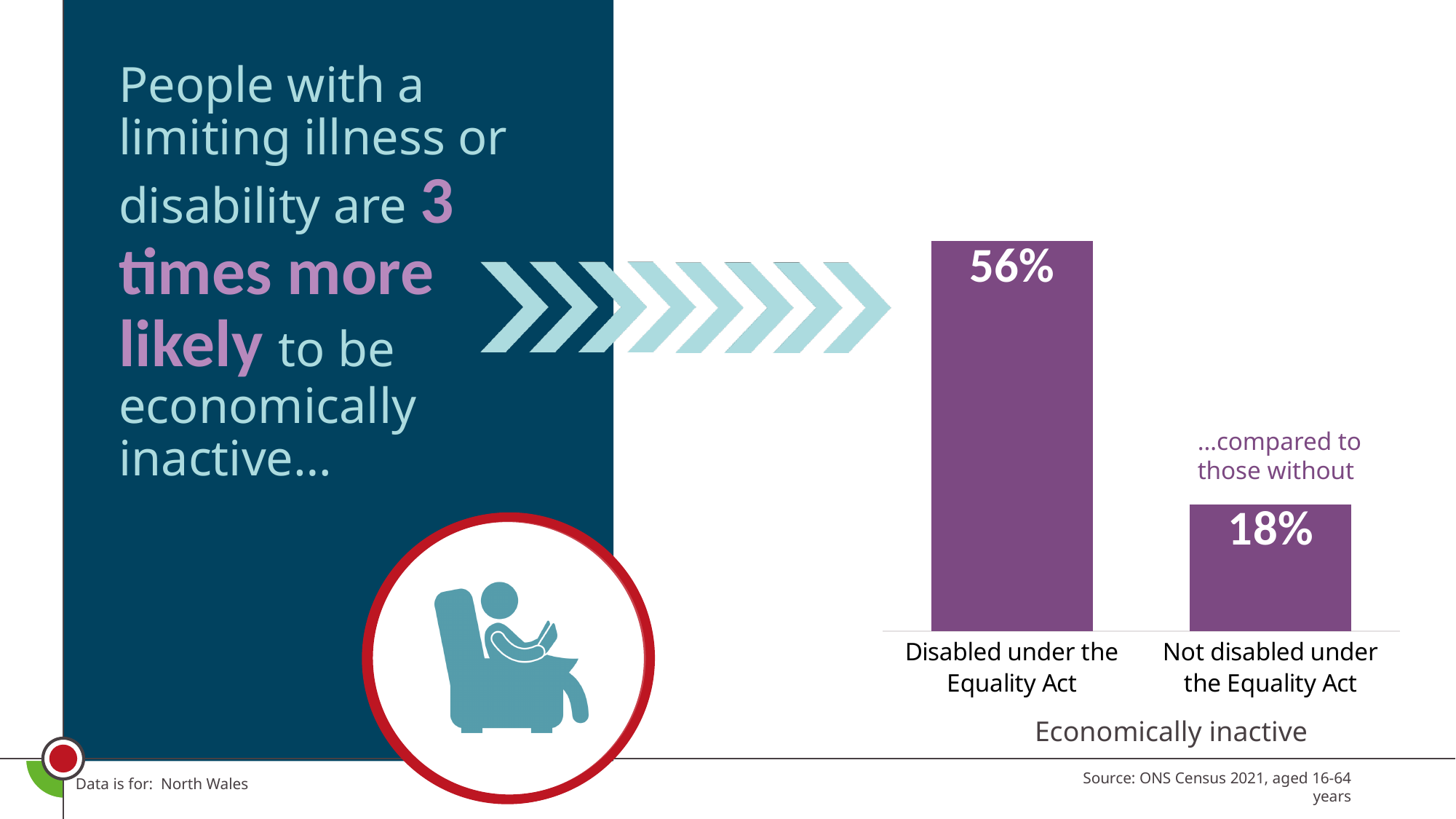
What is the difference in percentage points between the economically inactive rate for those disabled under the Equality Act and those not disabled? 38 percentage points Which area does the data on the slide cover? North Wales What is the label shown beneath the chart's category axis? Economically inactive How many categories are shown in the chart? 2 What percentage of people not disabled under the Equality Act are economically inactive? 18% What kind of chart is shown on the slide? Bar chart According to the slide text, how many times more likely are people with a limiting illness or disability to be economically inactive? 3 times Is the economically inactive rate larger for those disabled under the Equality Act or those not disabled under the Equality Act? Disabled under the Equality Act Which category has the higher economically inactive percentage? Disabled under the Equality Act Which category has the lower economically inactive percentage? Not disabled under the Equality Act What percentage of people disabled under the Equality Act are economically inactive? 56% What colour are the bars in the chart? Purple